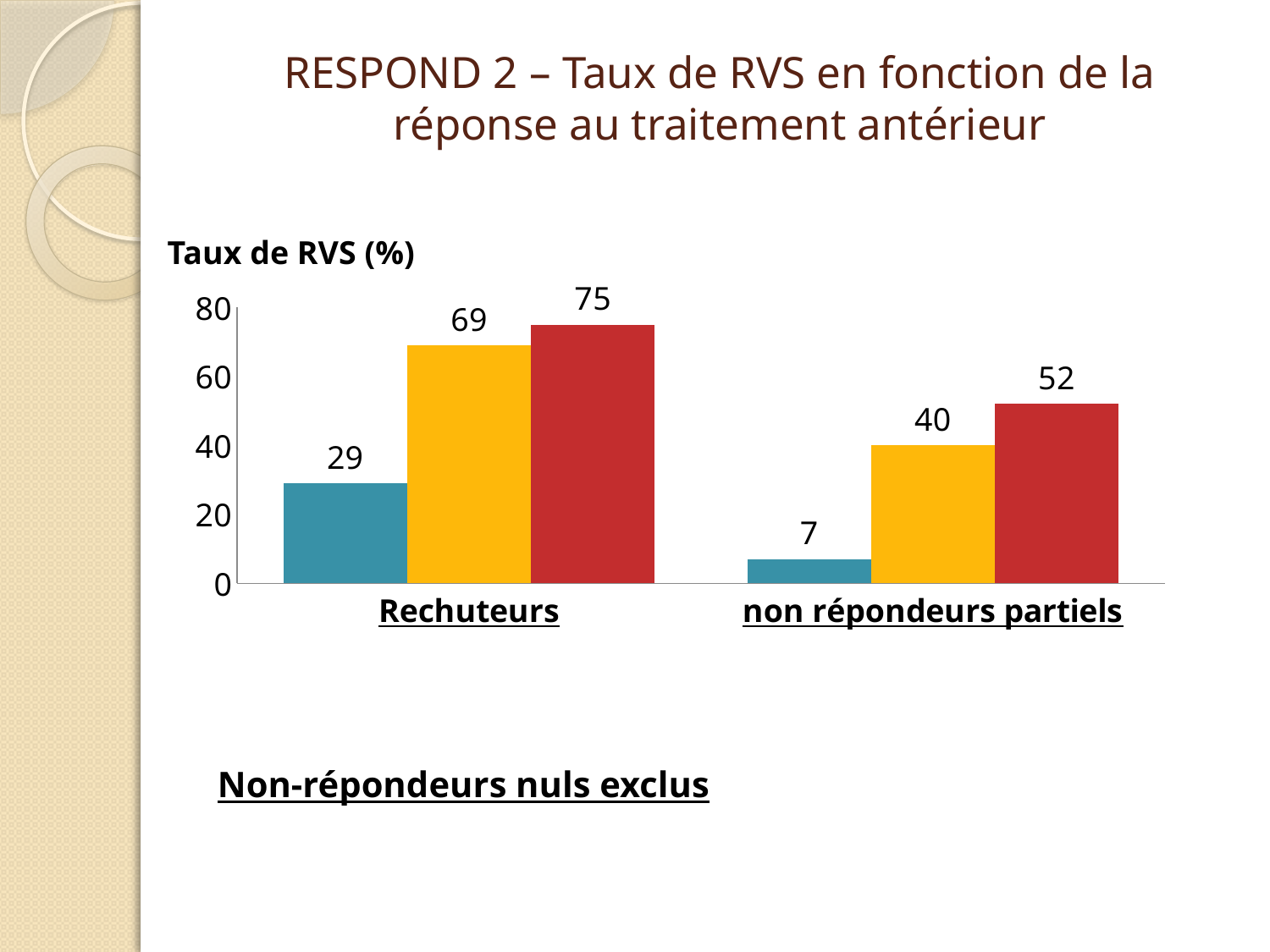
Which bar has the highest value on the chart? The red bar for Rechuteurs (75) What is the value of the yellow bar for non répondeurs partiels? 40 What is the label of the y axis of the chart? Taux de RVS (%) Which is larger: the red bar for non répondeurs partiels or the yellow bar for Rechuteurs? The yellow bar for Rechuteurs What is the value of the yellow bar for Rechuteurs? 69 What is the difference between the yellow bar for Rechuteurs and the yellow bar for non répondeurs partiels? 29 What is the value of the blue bar for Rechuteurs? 29 What is the value of the red bar for non répondeurs partiels? 52 What kind of chart is shown on the slide? Bar chart Which bar has the lowest value on the chart? The blue bar for non répondeurs partiels (7) What is the difference between the red bar and the blue bar for Rechuteurs? 46 How many categories are shown on the x axis? 2